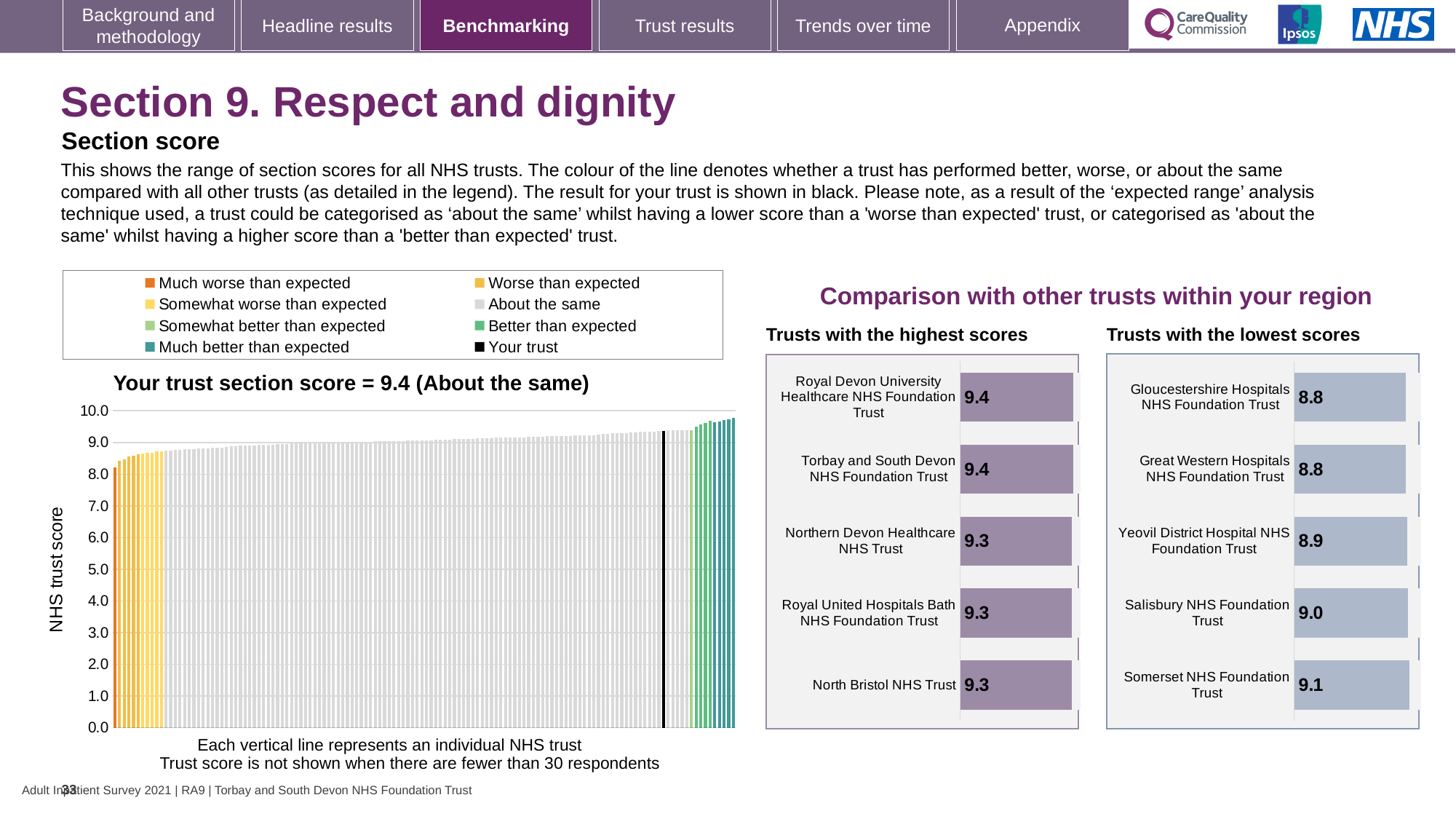
What type of chart is the 'Your trust section score' chart on the left? Bar chart In the 'Trusts with the lowest scores' chart, what is the score for Yeovil District Hospital NHS Foundation Trust? 8.9 In the 'Trusts with the highest scores' chart, what is the score for Northern Devon Healthcare NHS Trust? 9.3 In the 'Your trust section score' chart, is the value of the leftmost bar greater or less than 9.0? less In the 'Your trust section score' chart, do the bar values rise or fall from left to right along the x axis? Rise What is the y-axis label of the 'Your trust section score' chart? NHS trust score How many entries does the legend above the 'Your trust section score' chart list? 8 In the 'Trusts with the lowest scores' chart, which has the larger score: Salisbury NHS Foundation Trust or Great Western Hospitals NHS Foundation Trust? Salisbury NHS Foundation Trust How many trusts are listed in the 'Trusts with the highest scores' chart? 5 In the 'Trusts with the lowest scores' chart, what is the difference between the scores of Somerset NHS Foundation Trust and Gloucestershire Hospitals NHS Foundation Trust? 0.3 In the 'Trusts with the highest scores' chart, what is the score for Torbay and South Devon NHS Foundation Trust? 9.4 In the 'Trusts with the lowest scores' chart, which trust has the highest score? Somerset NHS Foundation Trust